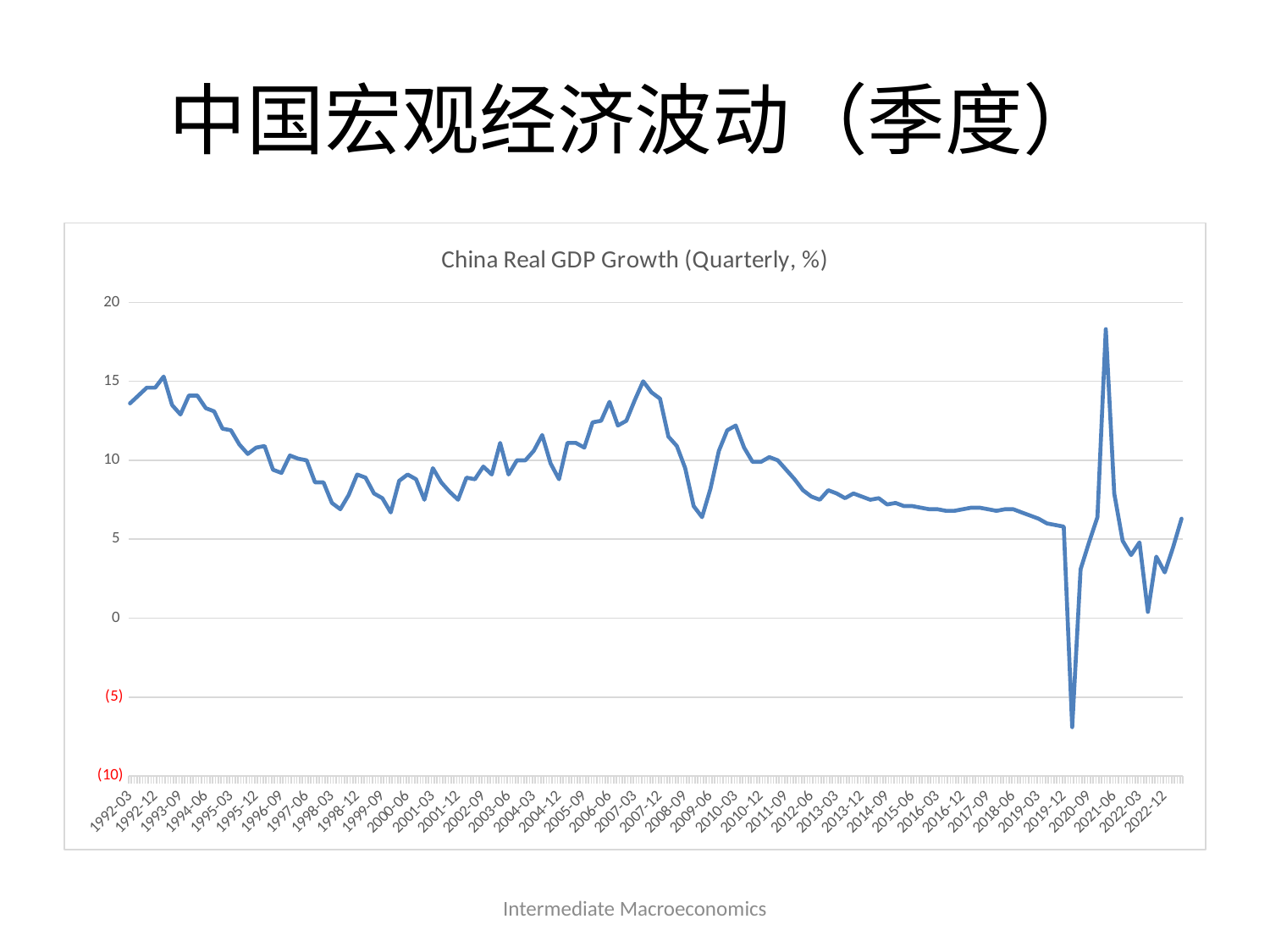
What is the title of the chart? China Real GDP Growth (Quarterly, %) Which is larger, the value for 1992-03 or the value for 2019-12? 1992-03 How many data series (lines) are plotted on the chart? 1 Is the value for 2016-03 greater or less than 5? greater What kind of chart is shown on the slide? line chart Do the values generally rise or fall from 1992-03 to 1998-03? fall Is the lowest value on the chart greater or less than 0? less Is the value for 1992-03 greater or less than 10? greater